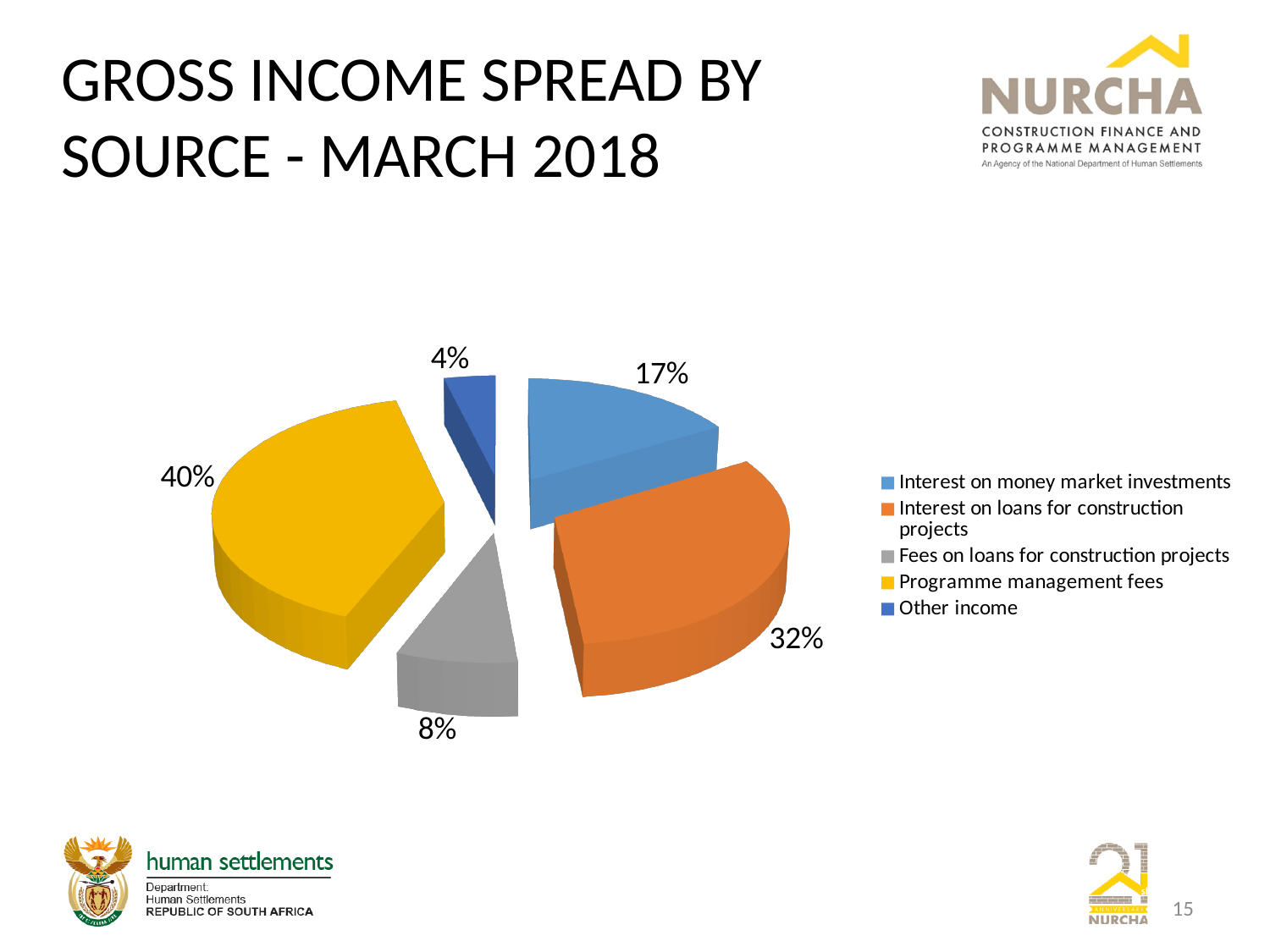
How many income sources are shown in the pie chart? 5 Which income source has the smallest share of gross income? Other income What colour is the slice for Programme management fees? Yellow Which income source has the largest share of gross income? Programme management fees Which is larger: the share for Interest on money market investments or the share for Fees on loans for construction projects? Interest on money market investments What share of gross income comes from Other income? 4% What share of gross income comes from Programme management fees? 40% What kind of chart is shown on the slide? Pie chart What share of gross income comes from Fees on loans for construction projects? 8% What is the difference in percentage points between Programme management fees and Interest on loans for construction projects? 8